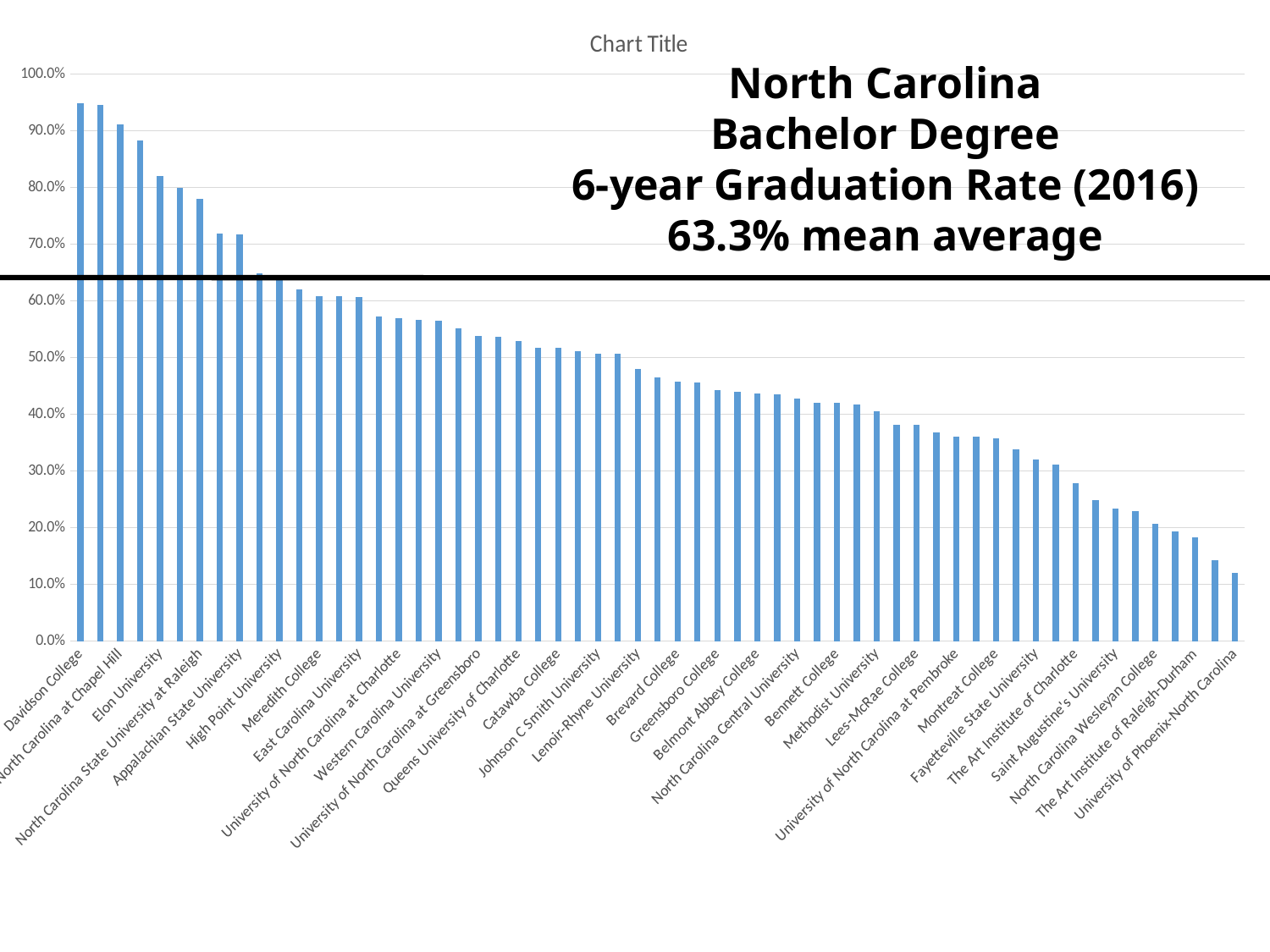
Is the value for North Carolina State University at Raleigh greater or less than 70.0%? greater What year does the graduation rate data on the slide refer to? 2016 Do the graduation rates rise or fall moving from left to right along the x axis? fall What mean average graduation rate is stated on the slide? 63.3% Is the value for University of Phoenix-North Carolina greater or less than 20.0%? less Is the value for Fayetteville State University greater or less than 40.0%? less What kind of chart is shown on the slide? bar chart Which has the larger graduation rate, Davidson College or University of Phoenix-North Carolina? Davidson College Which institution has the lowest 6-year graduation rate on the chart? University of Phoenix-North Carolina Which institution has the highest 6-year graduation rate on the chart? Davidson College